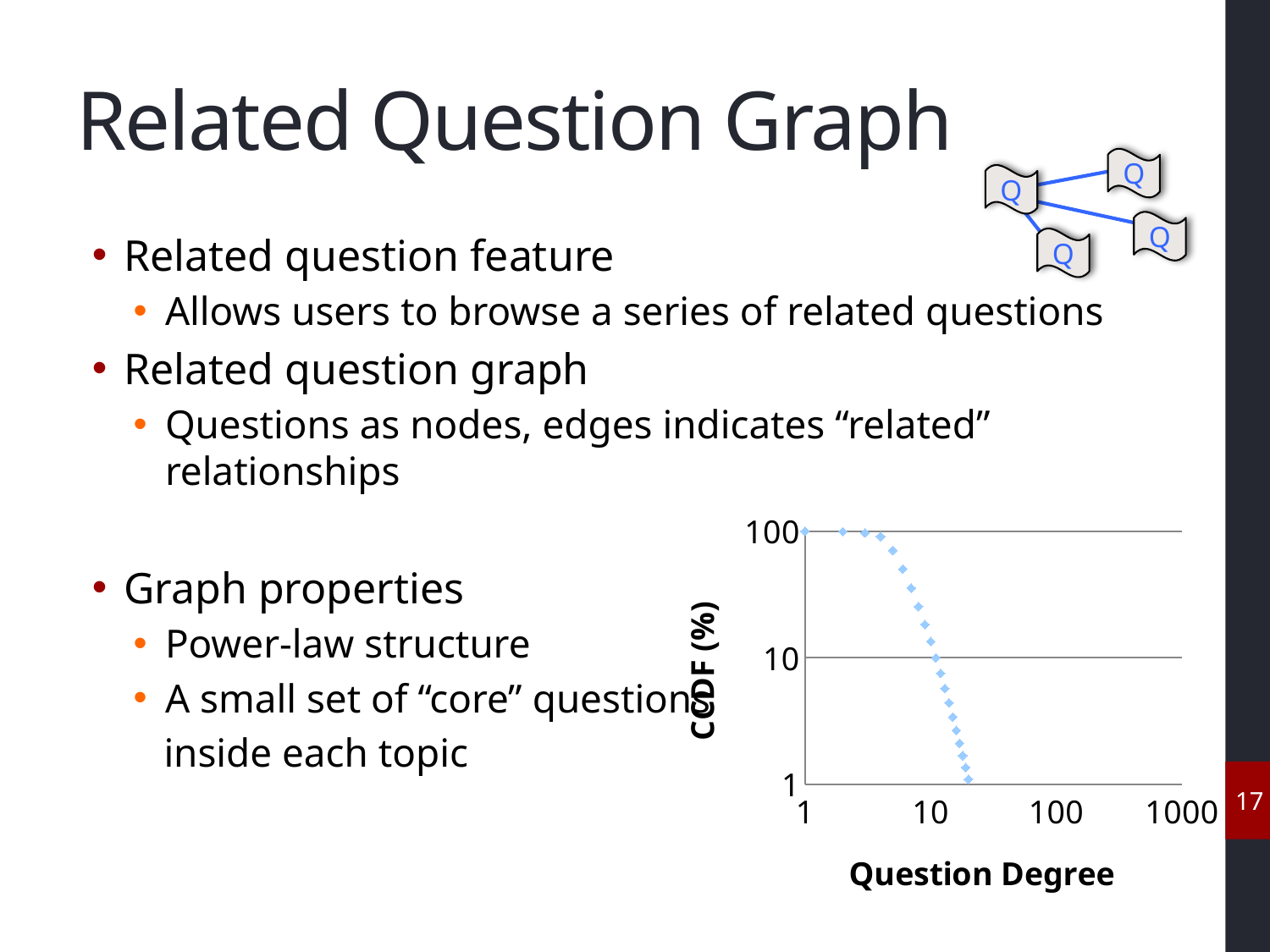
Is the CCDF value at a Question Degree of 20 greater or less than 10? less What is the largest tick value shown on the x axis of the chart? 1000 Is the CCDF value at a Question Degree of 2 greater or less than 10? greater What kind of chart is shown on the slide? scatter chart What is the highest value shown on the y axis of the chart? 100 What is the label of the y axis of the chart? CCDF (%) Is the CCDF value at a Question Degree of 15 greater or less than 10? less Does the CCDF rise or fall as Question Degree increases? fall Which has the higher CCDF value: a Question Degree of 2 or a Question Degree of 15? Question Degree of 2